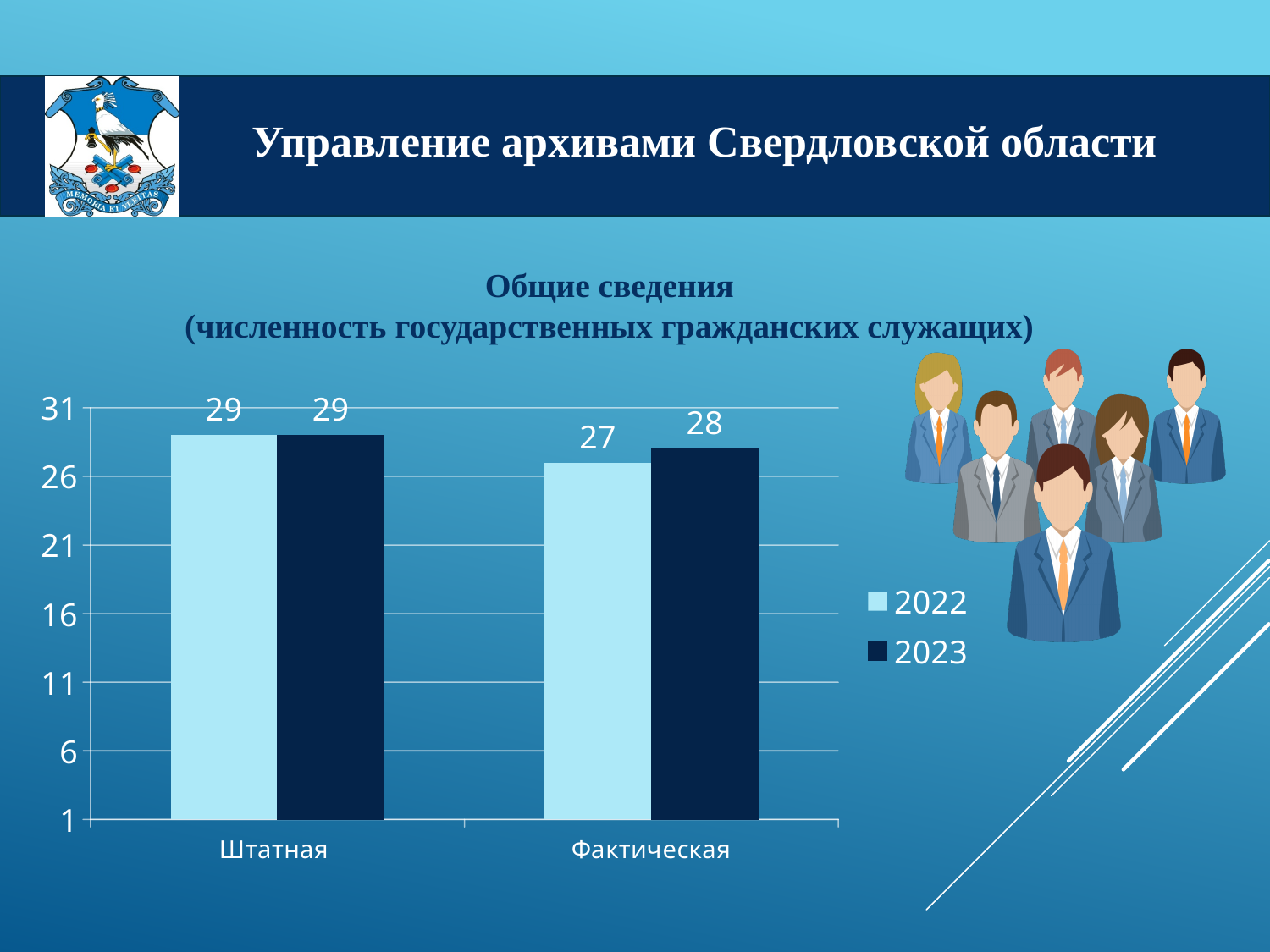
What is the difference between the Штатная and Фактическая values for 2022? 2 Which is larger for 2023: Штатная or Фактическая? Штатная What is the value for Фактическая in 2022? 27 How many series does the legend list? 2 Which series is shown in dark navy in the legend? 2023 What is the difference between the 2023 and 2022 values for Фактическая? 1 What is the value for Штатная in 2022? 29 Which category has the lowest value in 2022? Фактическая What kind of chart is shown on the slide? Bar chart What is the value for Фактическая in 2023? 28 What is the value for Штатная in 2023? 29 How many categories are shown on the x axis? 2